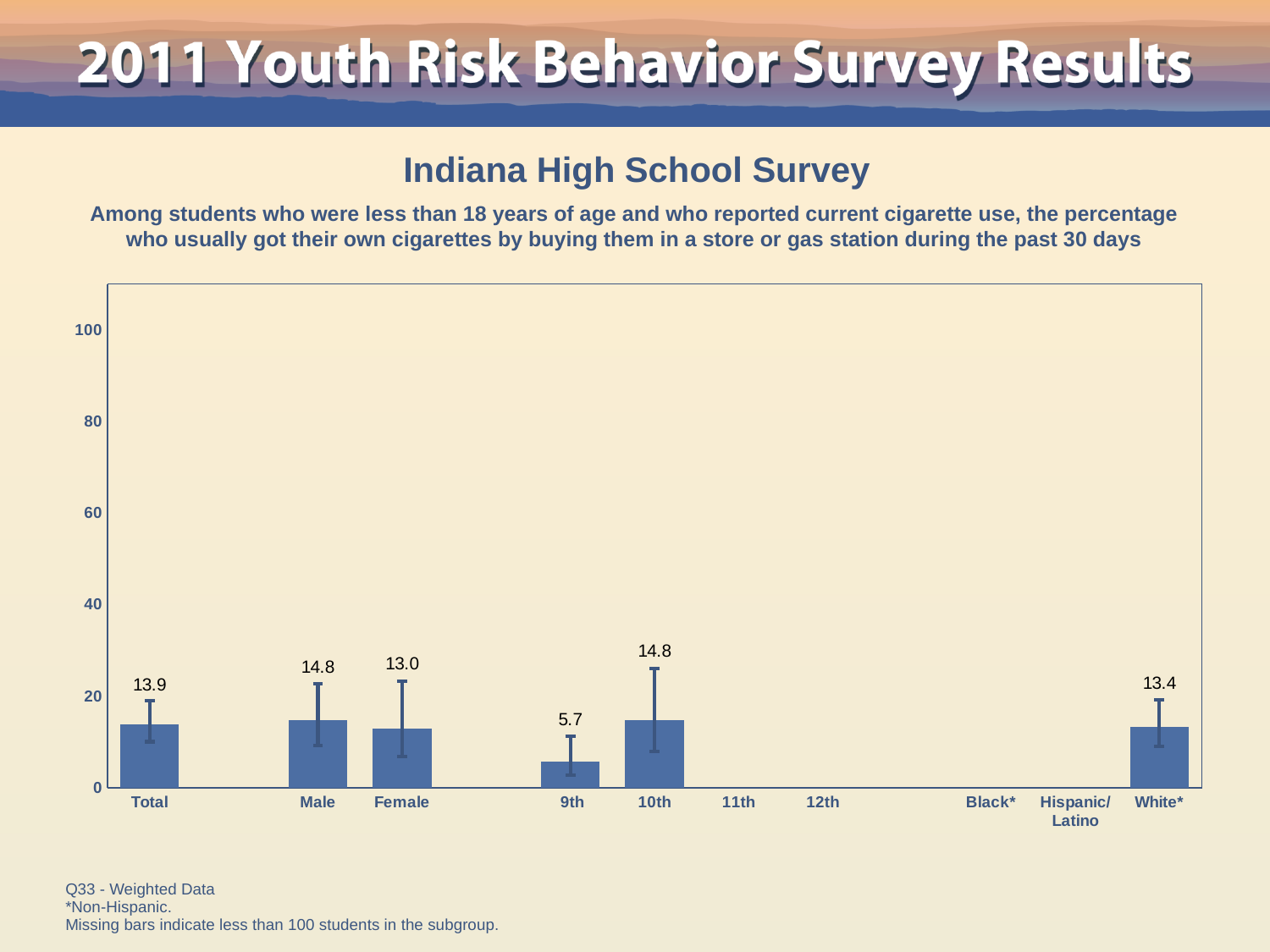
What is the value for Total? 13.9 Which is larger, the value for Total or the value for White*? Total What is the value for White*? 13.4 What is the value for Male? 14.8 What is the difference between the values for 10th and 9th? 9.1 What kind of chart is shown on the slide? bar chart What is the value for Female? 13.0 Which category with a plotted bar has the lowest value? 9th What is the difference between the values for Male and Female? 1.8 How many categories are labeled on the x axis? 10 Is the value for 10th greater or less than 20? less What is the value for 9th? 5.7